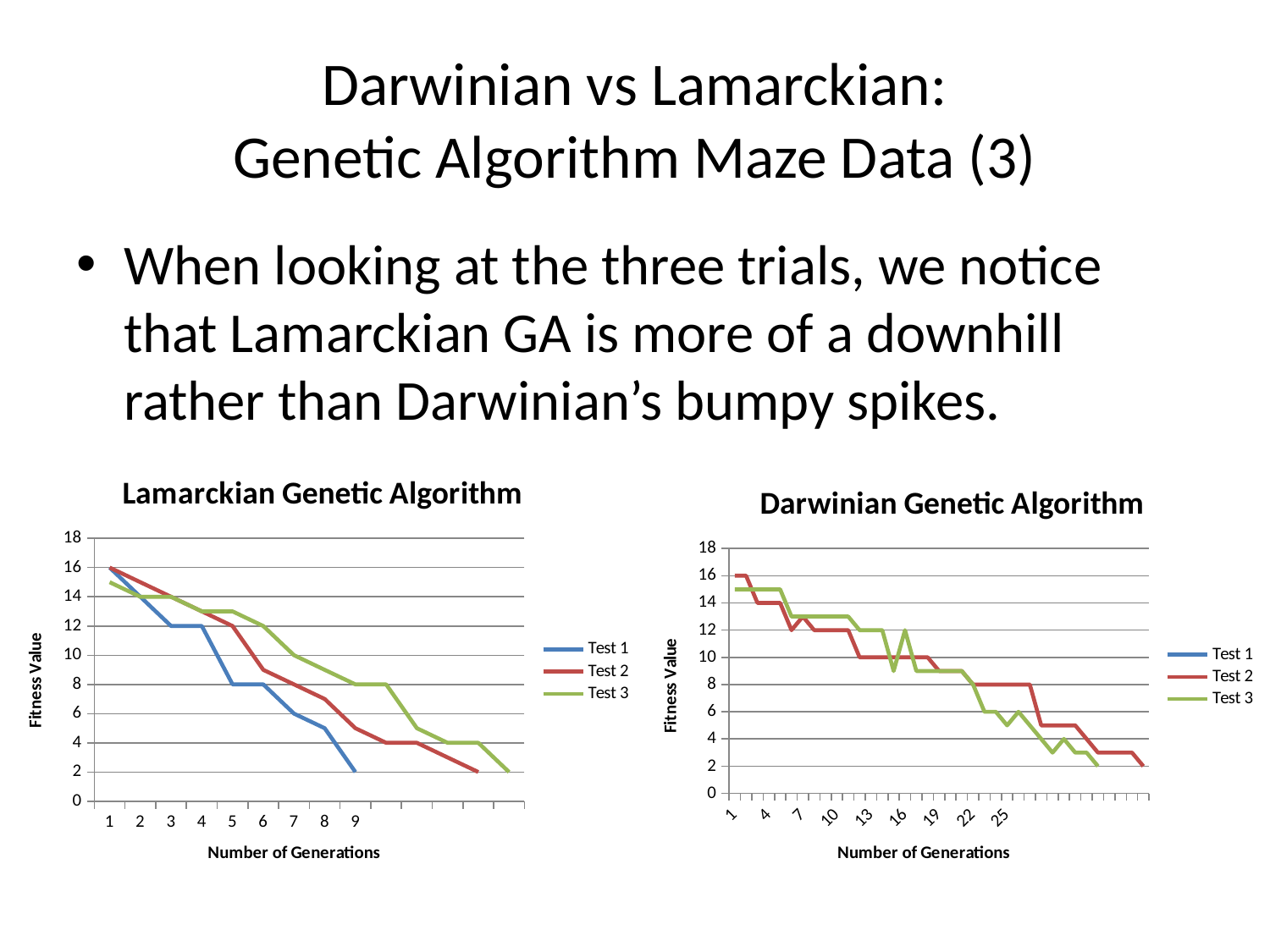
In the Lamarckian Genetic Algorithm chart, by how much does the Test 1 fitness value drop between generation 1 and generation 9? 14 In the Lamarckian Genetic Algorithm chart, what is the fitness value of Test 1 at generation 1? 16 In the Lamarckian Genetic Algorithm chart, which test has the lowest fitness value at generation 5? Test 1 What is the x-axis title of the Darwinian Genetic Algorithm chart? Number of Generations In the Lamarckian Genetic Algorithm chart, what is the fitness value of Test 1 at generation 3? 12 What kind of chart is the Lamarckian Genetic Algorithm chart? line chart How many series does the legend of the Darwinian Genetic Algorithm chart list? 3 In the Lamarckian Genetic Algorithm chart, what is the fitness value of Test 1 at generation 9? 2 In the Lamarckian Genetic Algorithm chart, what is the fitness value of Test 1 at generation 5? 8 In the Darwinian Genetic Algorithm chart, do the fitness values generally rise or fall as the number of generations increases? fall In the Lamarckian Genetic Algorithm chart, at generation 5, which is larger: Test 1 or Test 3? Test 3 In the Lamarckian Genetic Algorithm chart, is the Test 3 value at generation 7 greater or less than 8? greater